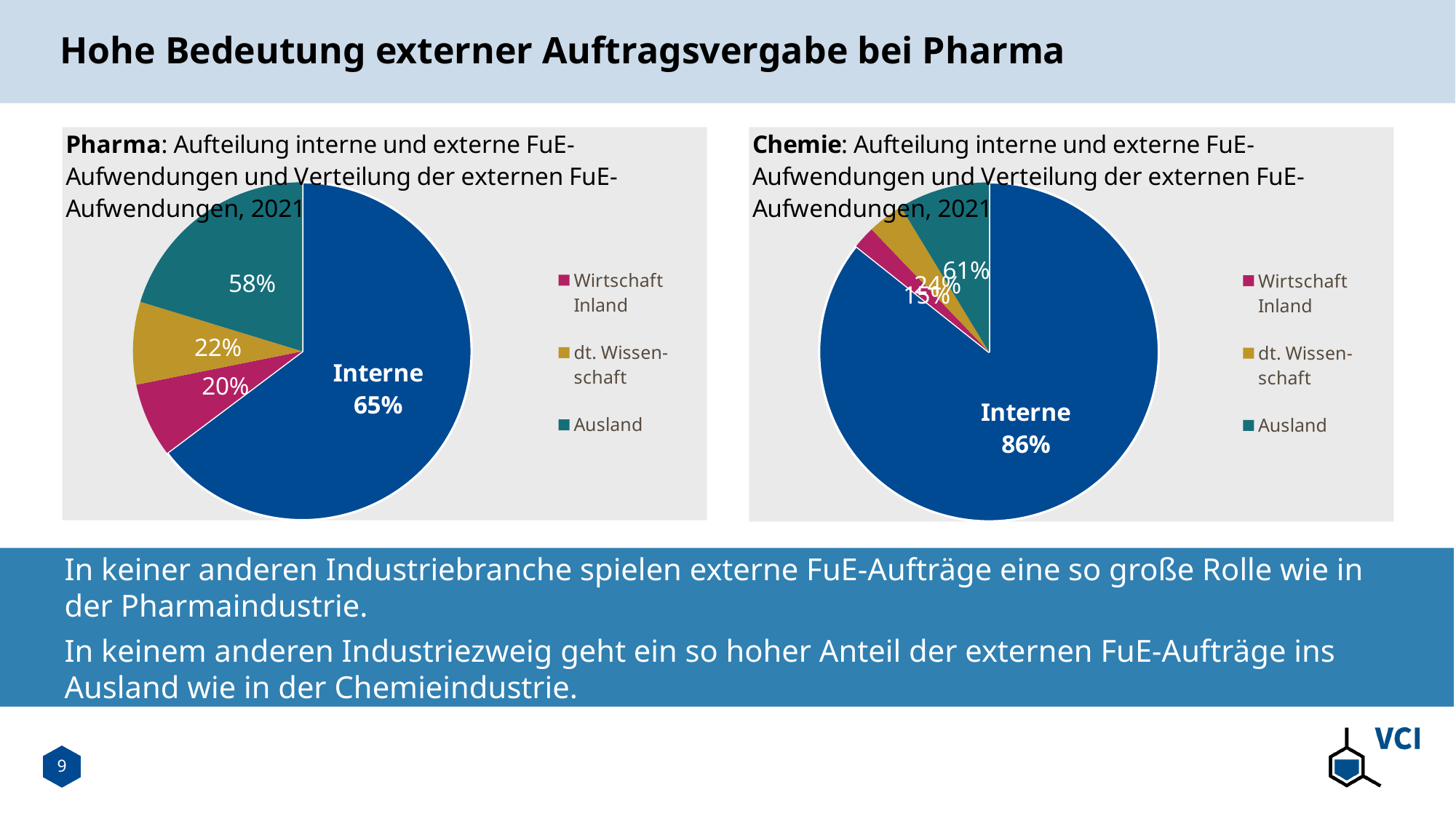
In the Pharma chart, what value is printed on the Wirtschaft Inland slice? 20% In the Chemie chart, what share is labelled for the Interne slice? 86% In the Pharma chart, which slice is the largest? Interne In the Pharma chart, what value is printed on the dt. Wissenschaft slice? 22% In the Pharma chart, what share is labelled for the Interne slice? 65% In the Chemie chart, what value is printed on the Ausland slice? 61% By how many percentage points does the Interne share in the Chemie chart exceed the Interne share in the Pharma chart? 21 percentage points In the Pharma chart, what value is printed on the Ausland slice? 58% Which year do the two charts refer to, according to their titles? 2021 Which chart shows the larger Interne share, Pharma or Chemie? Chemie How many entries does the legend of the Chemie chart list? 3 What type of chart is used for the Pharma data? Pie chart